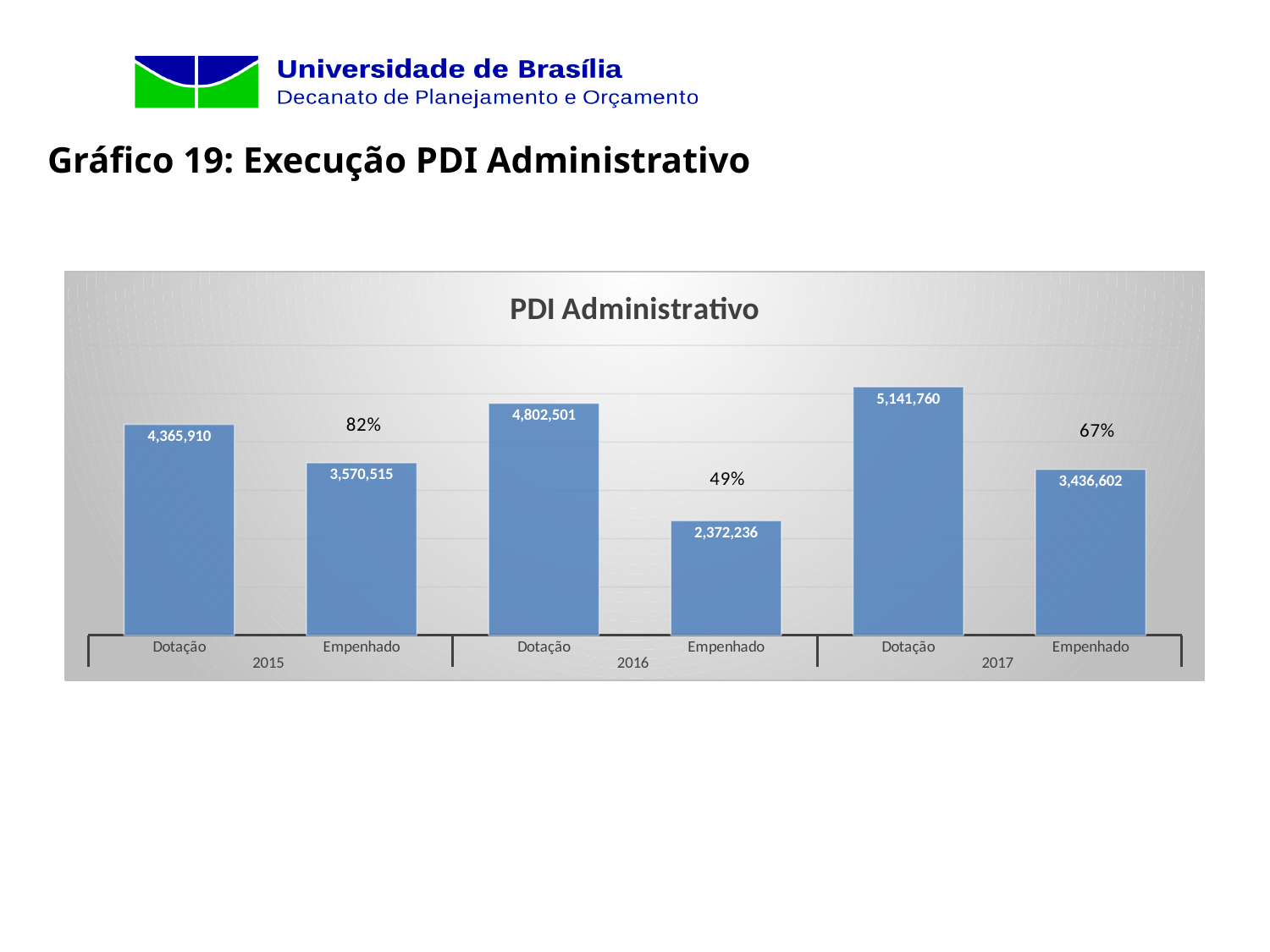
Which is larger, Empenhado in 2015 or Empenhado in 2017? Empenhado in 2015 What is the Empenhado value for 2016 in the PDI Administrativo chart? 2,372,236 What is the Dotação value for 2017 in the PDI Administrativo chart? 5,141,760 What is the difference between Dotação and Empenhado in 2015? 795,395 What kind of chart is shown on the slide? Bar chart Which bar has the lowest value in the PDI Administrativo chart? Empenhado 2016 What is the Dotação value for 2015 in the PDI Administrativo chart? 4,365,910 Which bar has the highest value in the PDI Administrativo chart? Dotação 2017 What percentage is shown above the Empenhado bar for 2015? 82% What is the difference between Dotação and Empenhado in 2016? 2,430,265 How many bars are plotted in the PDI Administrativo chart? 6 What percentage is shown above the Empenhado bar for 2017? 67%